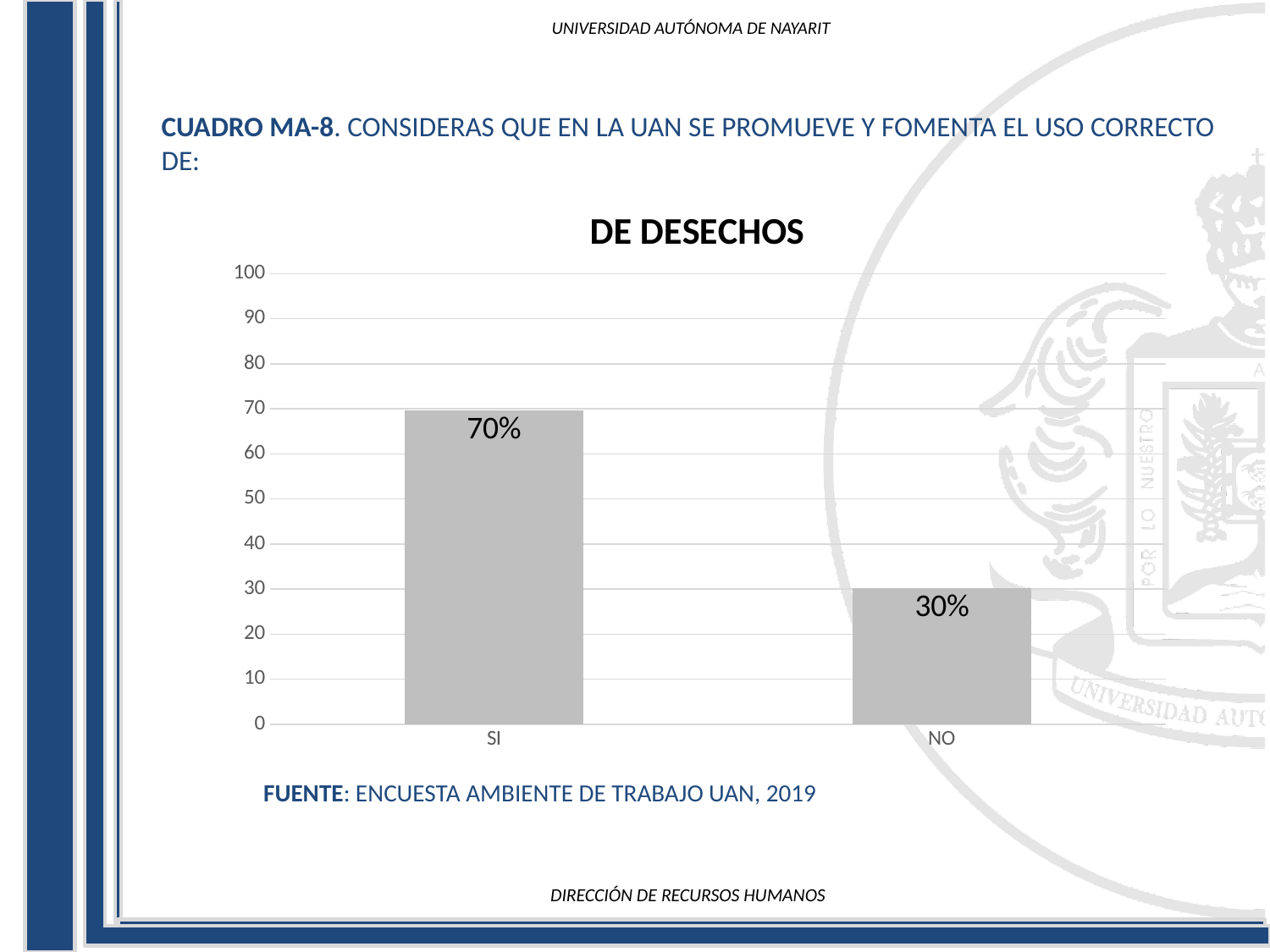
Which category has the highest value? SI What kind of chart is shown? bar chart What is the value for NO? 30% How many categories are shown on the x axis? 2 Which category has the lowest value? NO What is the difference between the values for SI and NO? 40% Which is larger, the value for SI or the value for NO? SI Is the value for NO greater or less than 40? less What is the highest value shown on the y axis? 100 What is the value for SI? 70% Is the value for SI greater or less than 50? greater What is the title of the chart? DE DESECHOS